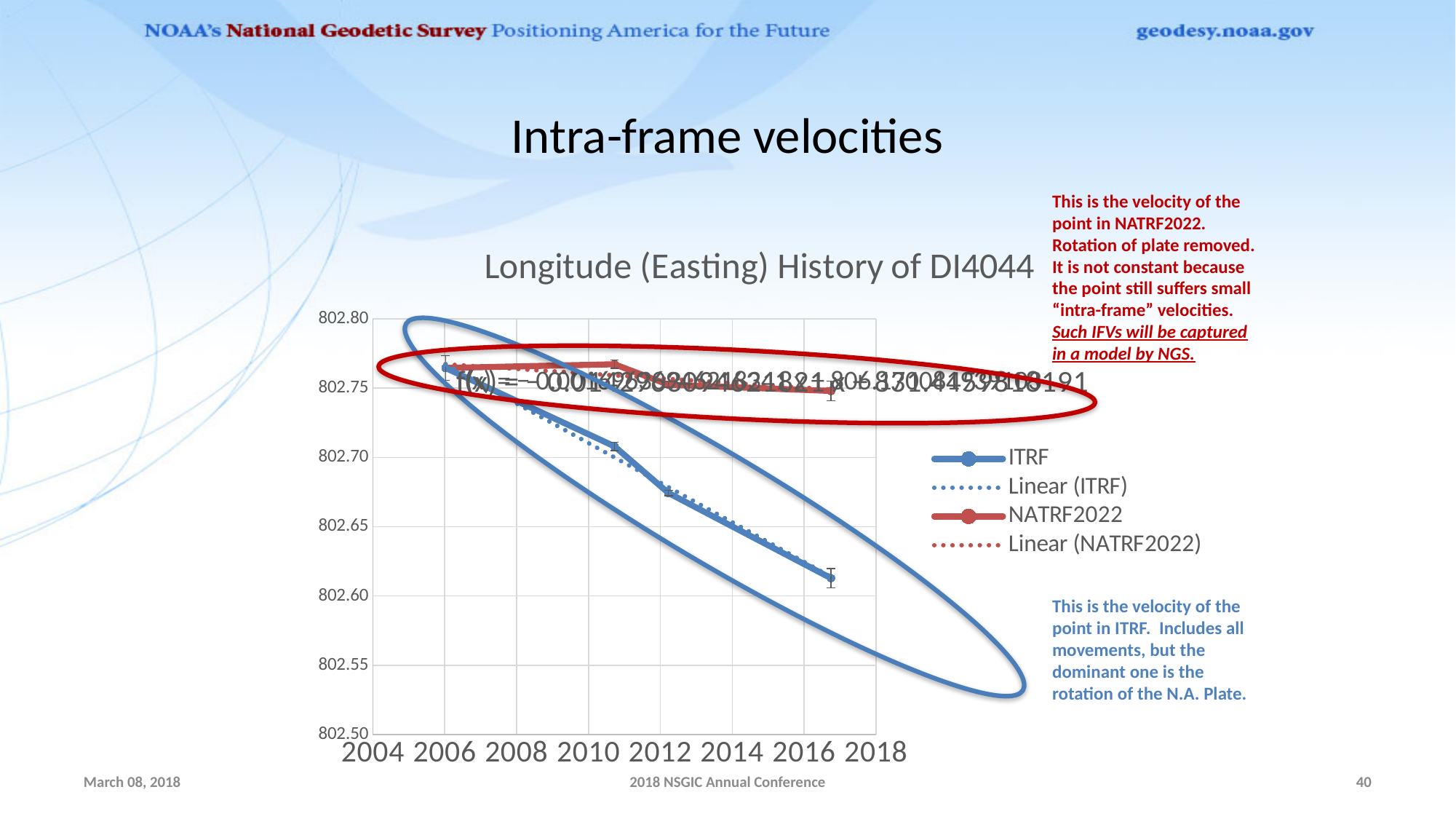
Is the NATRF2022 value at the last point (around 2017) greater or less than 802.70? greater Does the ITRF series rise or fall as the years increase along the x axis? fall Is the ITRF value at the first point (around 2006) greater or less than 802.75? greater What type of chart is shown on the slide? line chart Is the ITRF value at the point around 2012 greater or less than 802.70? less What is the title of the chart? Longitude (Easting) History of DI4044 Which series shows the larger overall decrease between 2006 and 2017, ITRF or NATRF2022? ITRF How many entries does the chart legend list? 4 At the last point (around 2017), which series has the higher value, ITRF or NATRF2022? NATRF2022 What is the lowest value shown on the y axis of the chart? 802.50 Which legend entry is drawn as a solid red line with markers? NATRF2022